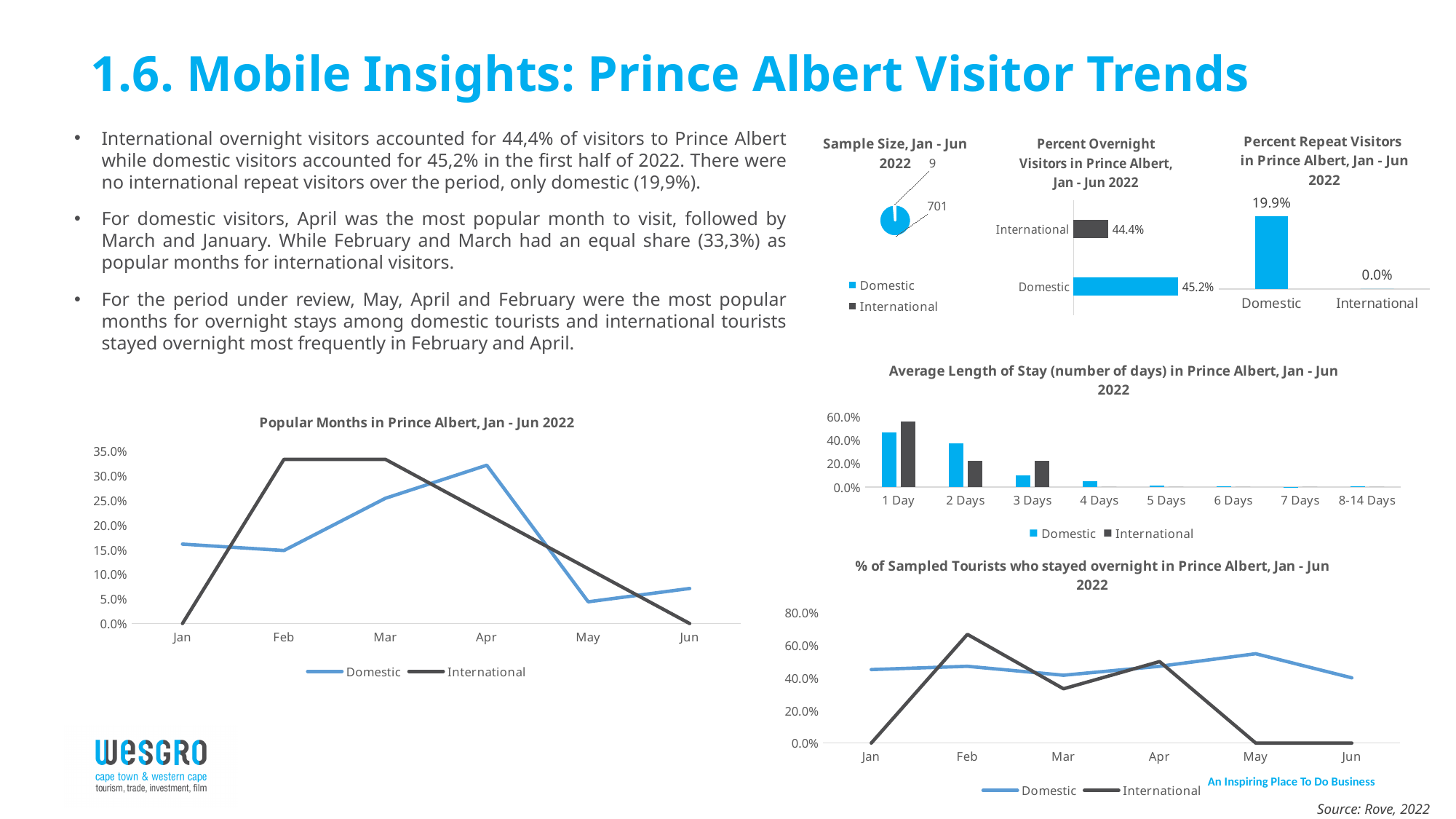
In the Popular Months in Prince Albert chart, is the International value for Feb greater or less than 30.0%? greater In the Percent Overnight Visitors in Prince Albert chart, which category has the higher value, Domestic or International? Domestic In the Percent Repeat Visitors in Prince Albert chart, what is the value for Domestic? 19.9% What kind of chart is the % of Sampled Tourists who stayed overnight in Prince Albert chart? Line chart In the Sample Size, Jan - Jun 2022 pie chart, what is the value for International? 9 How many categories are shown on the x axis of the Average Length of Stay chart? 8 In the Percent Overnight Visitors in Prince Albert chart, what is the value for International? 44.4% In the Popular Months in Prince Albert chart, which month has the highest Domestic value? Apr In the Sample Size, Jan - Jun 2022 pie chart, what is the value for Domestic? 701 In the Percent Repeat Visitors in Prince Albert chart, what is the value for International? 0.0% In the Average Length of Stay chart, is the International value for 1 Day greater or less than 40.0%? greater In the Percent Overnight Visitors in Prince Albert chart, what is the difference between the Domestic and International values? 0.8%